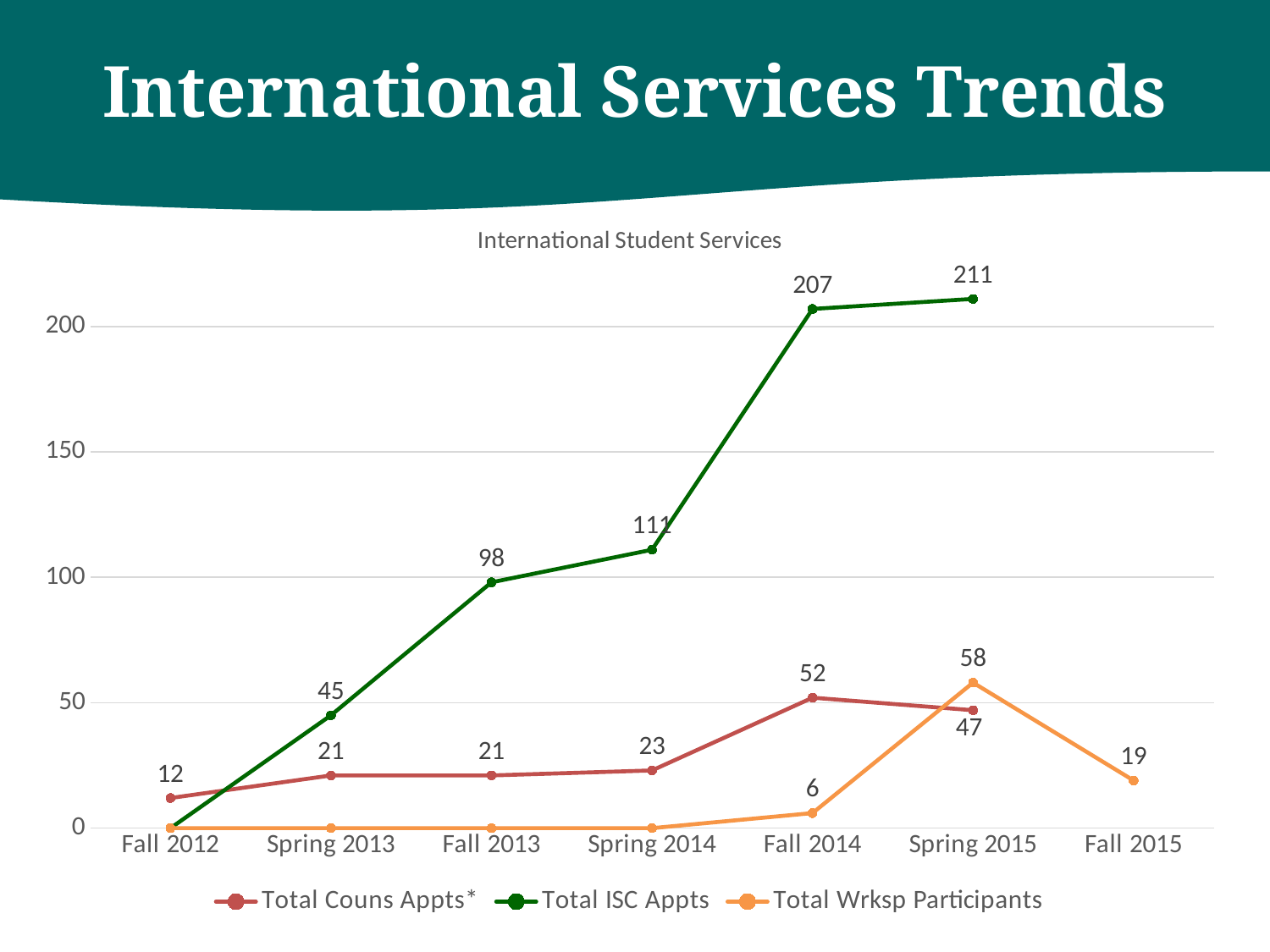
How many periods are shown on the x axis? 7 In which period is Total Couns Appts* lowest? Fall 2012 What kind of chart is shown on the slide? line chart What is the value of Total Wrksp Participants in Fall 2015? 19 Is the value for Total ISC Appts in Fall 2012 greater or less than 50? less How many series does the legend list? 3 In Spring 2015, which is larger: Total Wrksp Participants or Total Couns Appts*? Total Wrksp Participants What is the value of Total Wrksp Participants in Spring 2015? 58 What is the value of Total Couns Appts* in Fall 2014? 52 By how much did Total ISC Appts increase from Fall 2014 to Spring 2015? 4 What is the value of Total ISC Appts in Fall 2014? 207 In which period is Total ISC Appts highest? Spring 2015